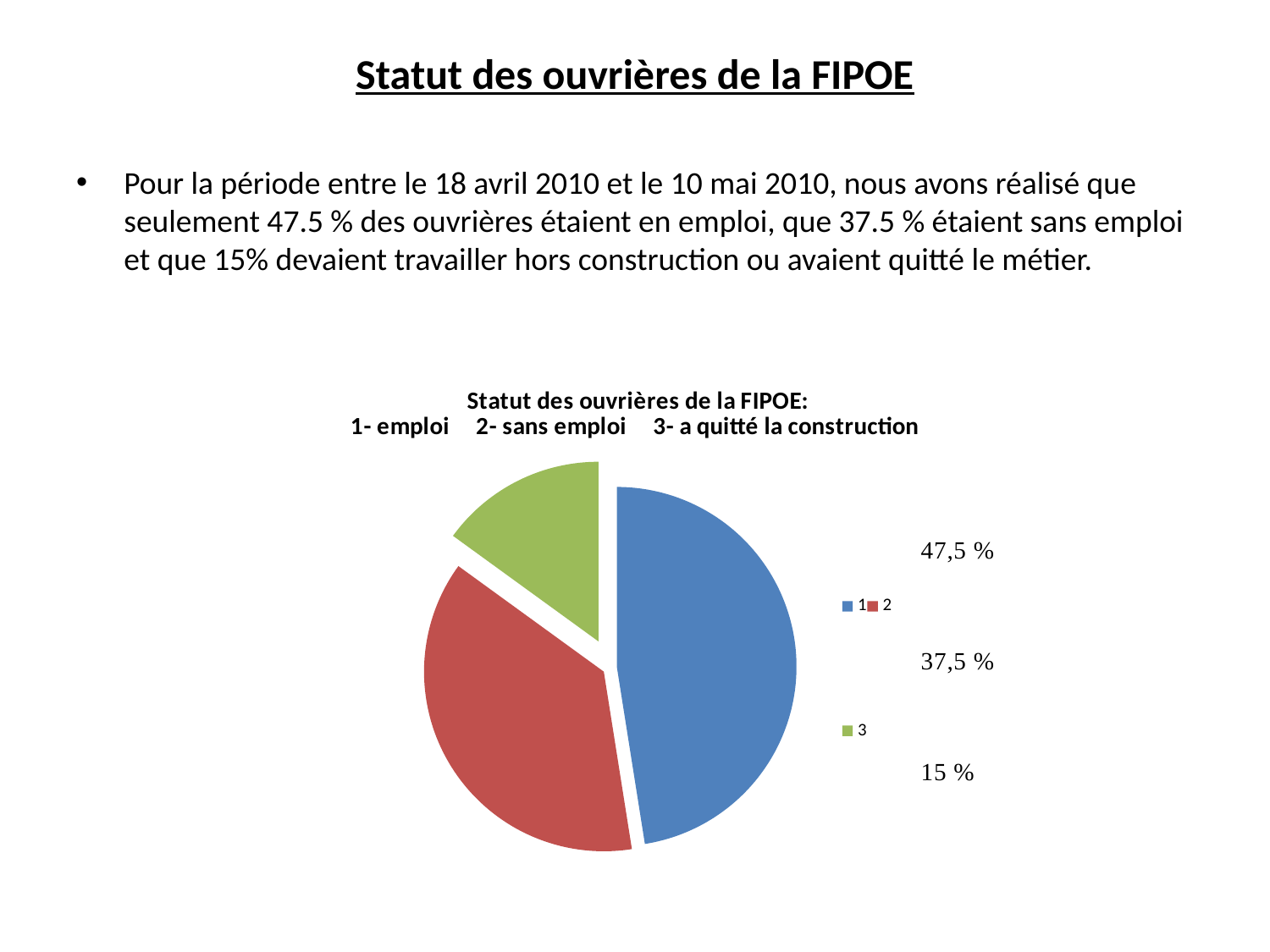
What is the difference in percentage points between category 1 (emploi) and category 2 (sans emploi)? 10 Which is larger, the slice for category 2 (sans emploi) or the slice for category 3 (a quitté la construction)? category 2 (sans emploi) What kind of chart is shown on the slide? pie chart What colour is the slice for category 3 (a quitté la construction)? green Which category has the largest slice of the pie? 1 (emploi) How many slices does the pie chart have? 3 What share of the pie does category 2 (sans emploi) represent? 37,5 % What is the difference in percentage points between category 2 (sans emploi) and category 3 (a quitté la construction)? 22,5 What is the title of the chart? Statut des ouvrières de la FIPOE: 1- emploi 2- sans emploi 3- a quitté la construction What share of the pie does category 3 (a quitté la construction) represent? 15 % What share of the pie does category 1 (emploi) represent? 47,5 % Which category has the smallest slice of the pie? 3 (a quitté la construction)